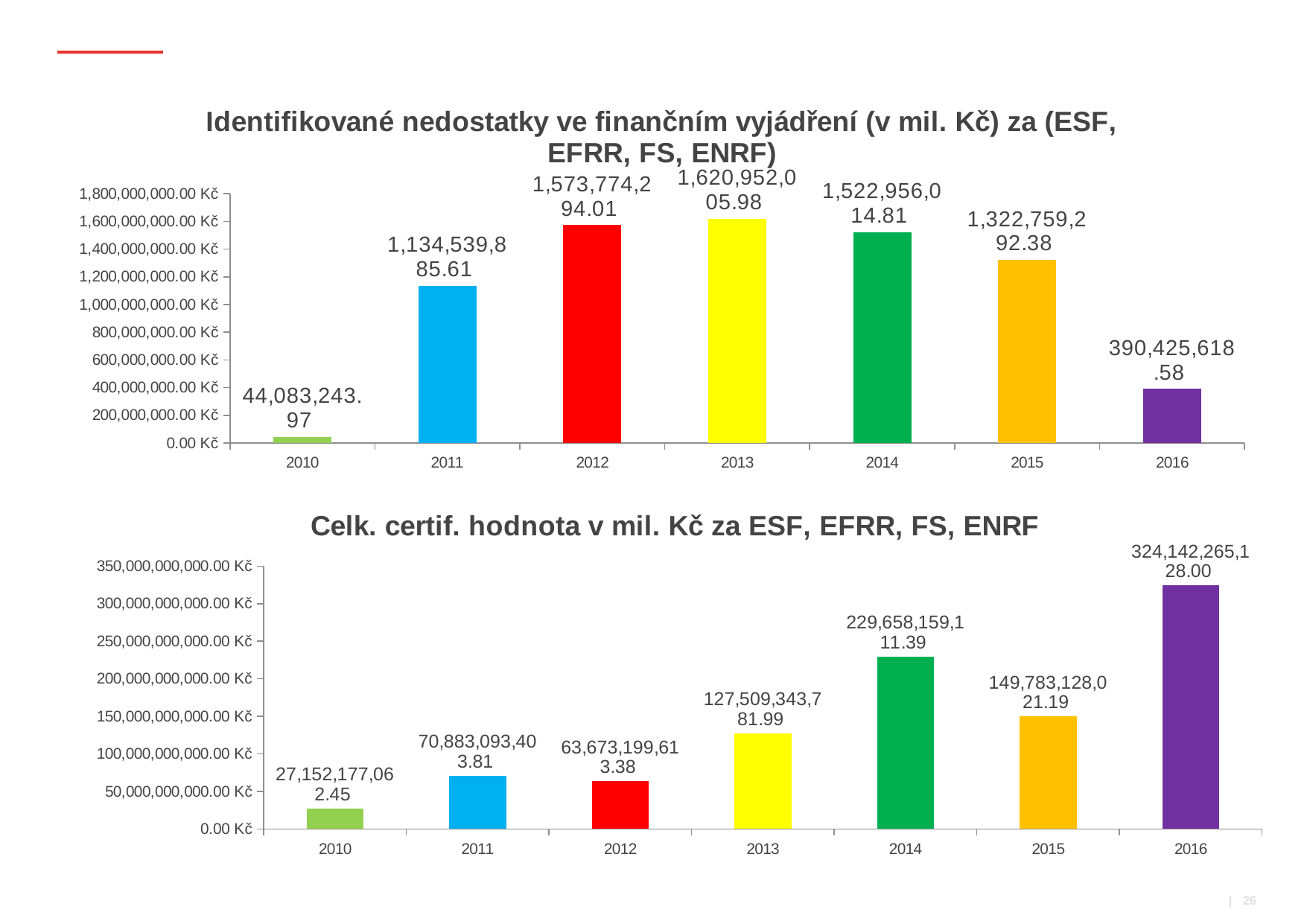
What type of chart is the bottom chart (Celk. certif. hodnota)? bar chart In the bottom chart (Celk. certif. hodnota), what is the value for 2016? 324,142,265,128.00 In the top chart (Identifikované nedostatky ve finančním vyjádření), which year has the highest value? 2013 In the bottom chart (Celk. certif. hodnota), how many years are shown on the x axis? 7 In the top chart (Identifikované nedostatky ve finančním vyjádření), what is the difference between the values for 2013 and 2012? 47,177,711.97 In the bottom chart (Celk. certif. hodnota), what is the difference between the values for 2016 and 2014? 94,484,106,016.61 In the bottom chart (Celk. certif. hodnota), which is larger, the value for 2011 or the value for 2012? 2011 In the top chart (Identifikované nedostatky ve finančním vyjádření), what is the value for 2013? 1,620,952,005.98 In the top chart (Identifikované nedostatky ve finančním vyjádření), what is the value for 2010? 44,083,243.97 In the bottom chart (Celk. certif. hodnota), what is the value for 2012? 63,673,199,613.38 In the top chart (Identifikované nedostatky ve finančním vyjádření), is the value for 2016 greater or less than 400,000,000.00 Kč? less In the top chart (Identifikované nedostatky ve finančním vyjádření), which year has the lowest value? 2010